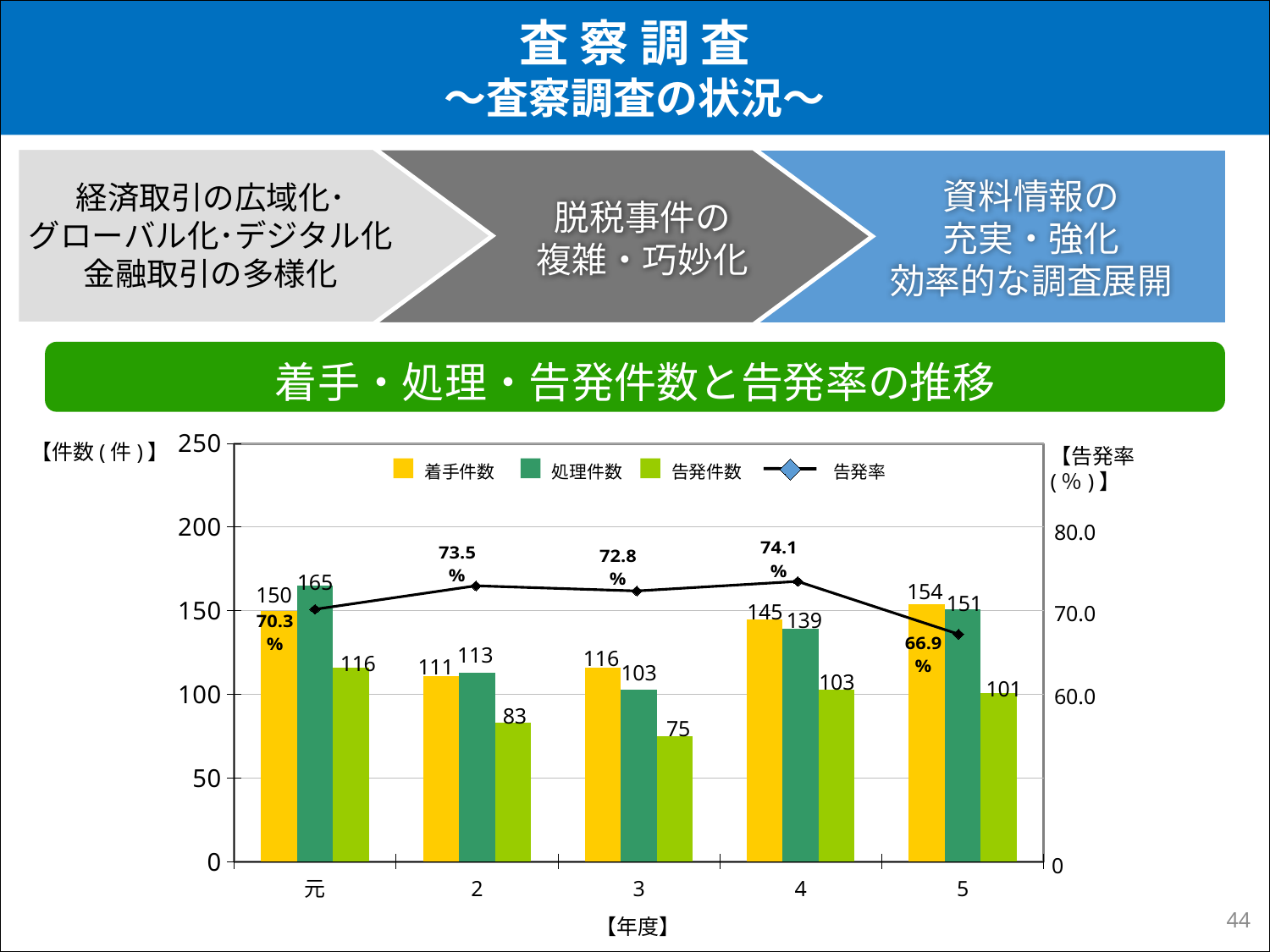
Which 年度 has the lowest 告発件数? 3 Which is larger for 年度 2: 着手件数 or 処理件数? 処理件数 How many series does the legend list? 4 Does the 告発率 rise or fall from 年度 4 to 年度 5? Fall What kind of chart is this? Combined bar and line chart What is the 告発率 for 年度 4? 74.1% What is the difference between 着手件数 and 処理件数 for 年度 4? 6 What is the 処理件数 value for 年度 元? 165 What is the 告発件数 value for 年度 3? 75 How many 年度 categories are shown on the x axis? 5 Which 年度 has the highest 告発率? 4 What is the 着手件数 value for 年度 5? 154